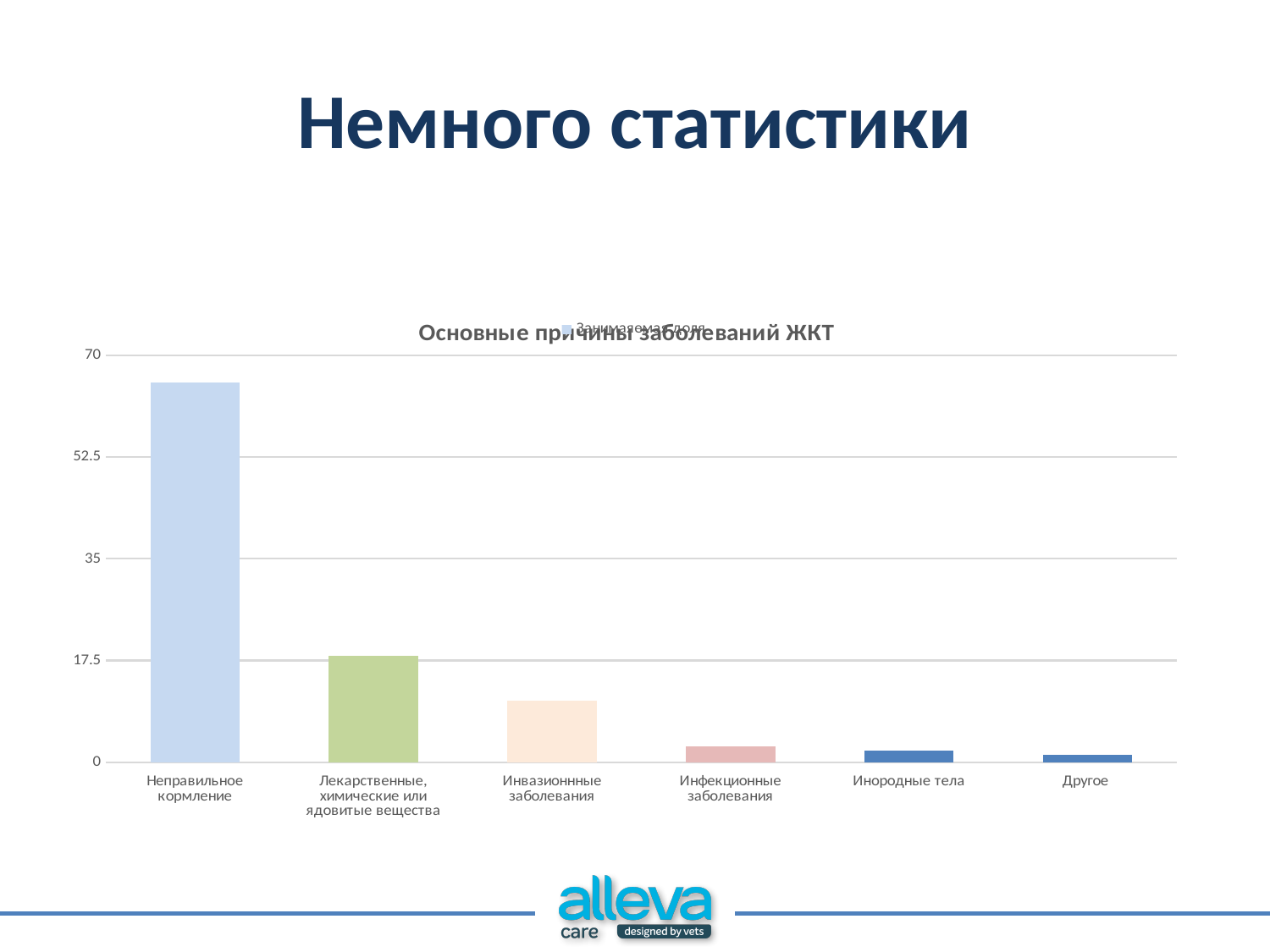
Is the value for Инфекционные заболевания greater or less than 17.5? less Is the value for Лекарственные, химические или ядовитые вещества greater or less than 35? less Which is larger: the value for Лекарственные, химические или ядовитые вещества or the value for Инвазионнные заболевания? Лекарственные, химические или ядовитые вещества Which is larger: the value for Инфекционные заболевания or the value for Инородные тела? Инфекционные заболевания What type of chart is shown on the slide? bar chart How many categories are shown on the x axis of the chart? 6 Which category has the highest value in the chart? Неправильное кормление Is the value for Инвазионнные заболевания greater or less than 17.5? less What is the title of the chart? Основные причины заболеваний ЖКТ Do the values rise or fall moving from left to right along the x axis? fall How many series does the chart's legend list? 1